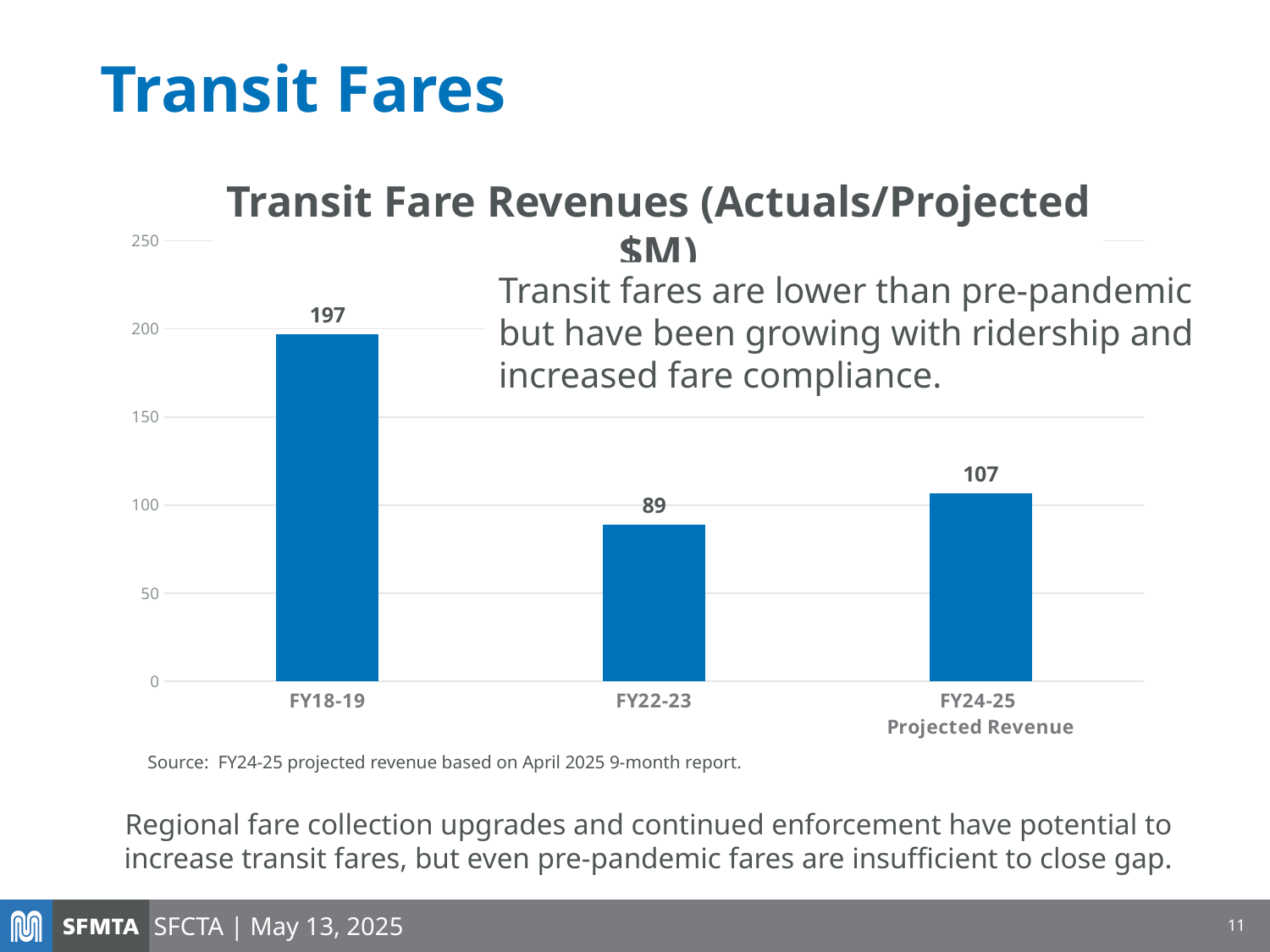
Is the transit fare revenue for FY18-19 greater or less than 150? greater How many fiscal years are shown in the chart? 3 What is the difference between the FY18-19 and FY22-23 transit fare revenue values? 108 Which is larger, the transit fare revenue for FY22-23 or the projected revenue for FY24-25? FY24-25 What is the transit fare revenue value for FY22-23? 89 Which fiscal year has the highest transit fare revenue? FY18-19 What is the projected transit fare revenue value for FY24-25? 107 What is the transit fare revenue value for FY18-19? 197 What is the title of the chart? Transit Fare Revenues (Actuals/Projected $M) Which fiscal year has the lowest transit fare revenue? FY22-23 What is the difference between the FY24-25 projected and FY22-23 transit fare revenue values? 18 What kind of chart is used to show transit fare revenues? Bar chart